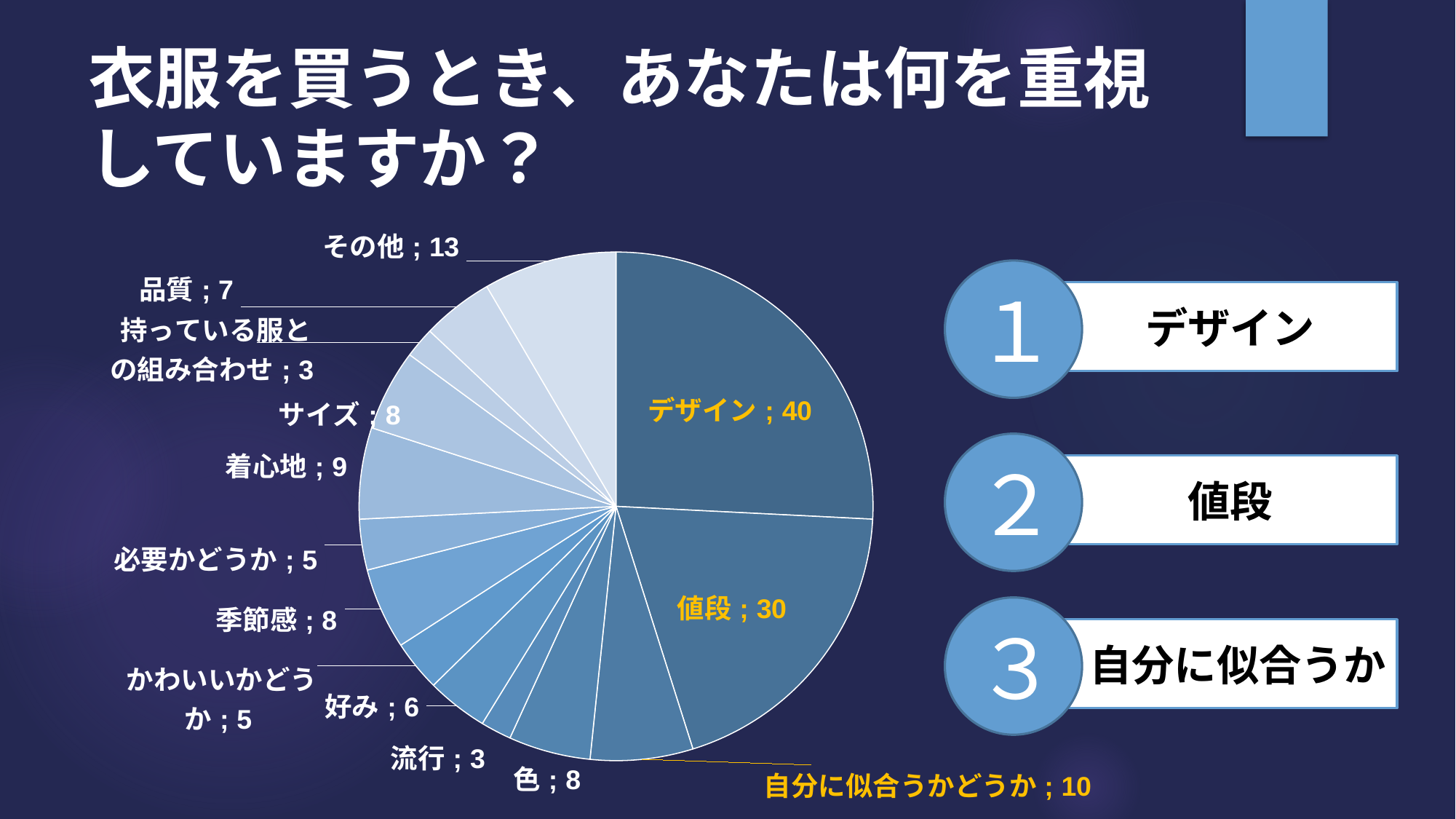
What is the value for 自分に似合うかどうか in the pie chart? 10 What is the value for 着心地 in the pie chart? 9 What is the value for 値段 in the pie chart? 30 What is the value for デザイン in the pie chart? 40 Which is larger, the value for 着心地 or the value for 品質? 着心地 What is the value for その他 in the pie chart? 13 Which category has the largest slice in the pie chart? デザイン What kind of chart is shown on the slide? pie chart How many categories are shown in the pie chart? 14 What is the difference between the values for デザイン and 値段? 10 What is the value for 持っている服との組み合わせ in the pie chart? 3 What is the title of the slide containing the pie chart? 衣服を買うとき、あなたは何を重視していますか？